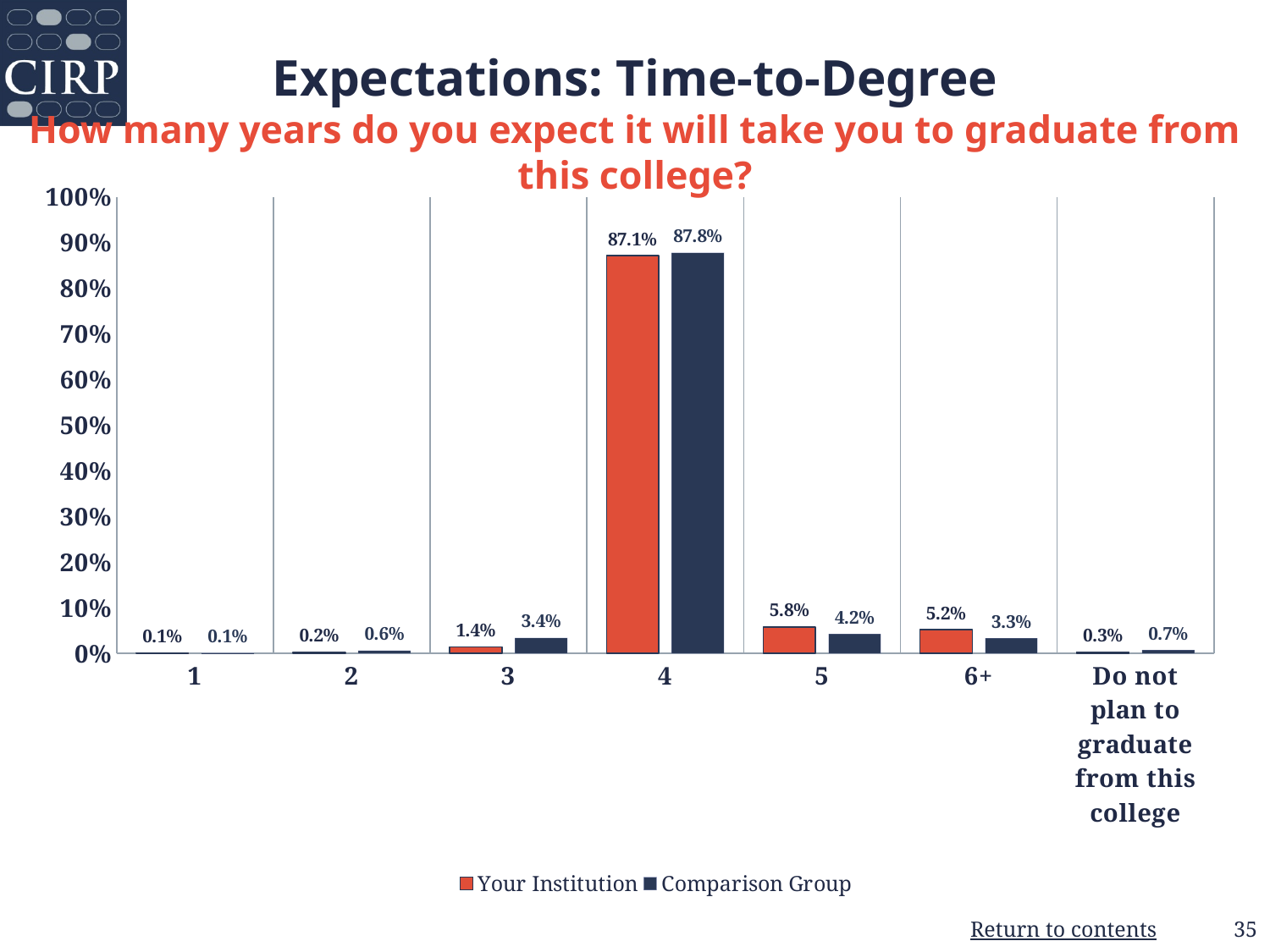
Which category has the lowest value for Comparison Group? 1 Is the value for Your Institution in the 4 category greater or less than 80%? greater What is the difference between Your Institution and Comparison Group in the 5 category? 1.6% Which category has the highest value for Your Institution? 4 How many categories are shown on the x axis? 7 How many series does the legend list? 2 What is the value for Comparison Group in the 'Do not plan to graduate from this college' category? 0.7% What is the value for Your Institution in the 4 category? 87.1% What kind of chart is shown on the slide? bar chart In the 3 category, which series has the larger value, Your Institution or Comparison Group? Comparison Group What is the value for Comparison Group in the 6+ category? 3.3% What is the difference between the Comparison Group and Your Institution values in the 4 category? 0.7%